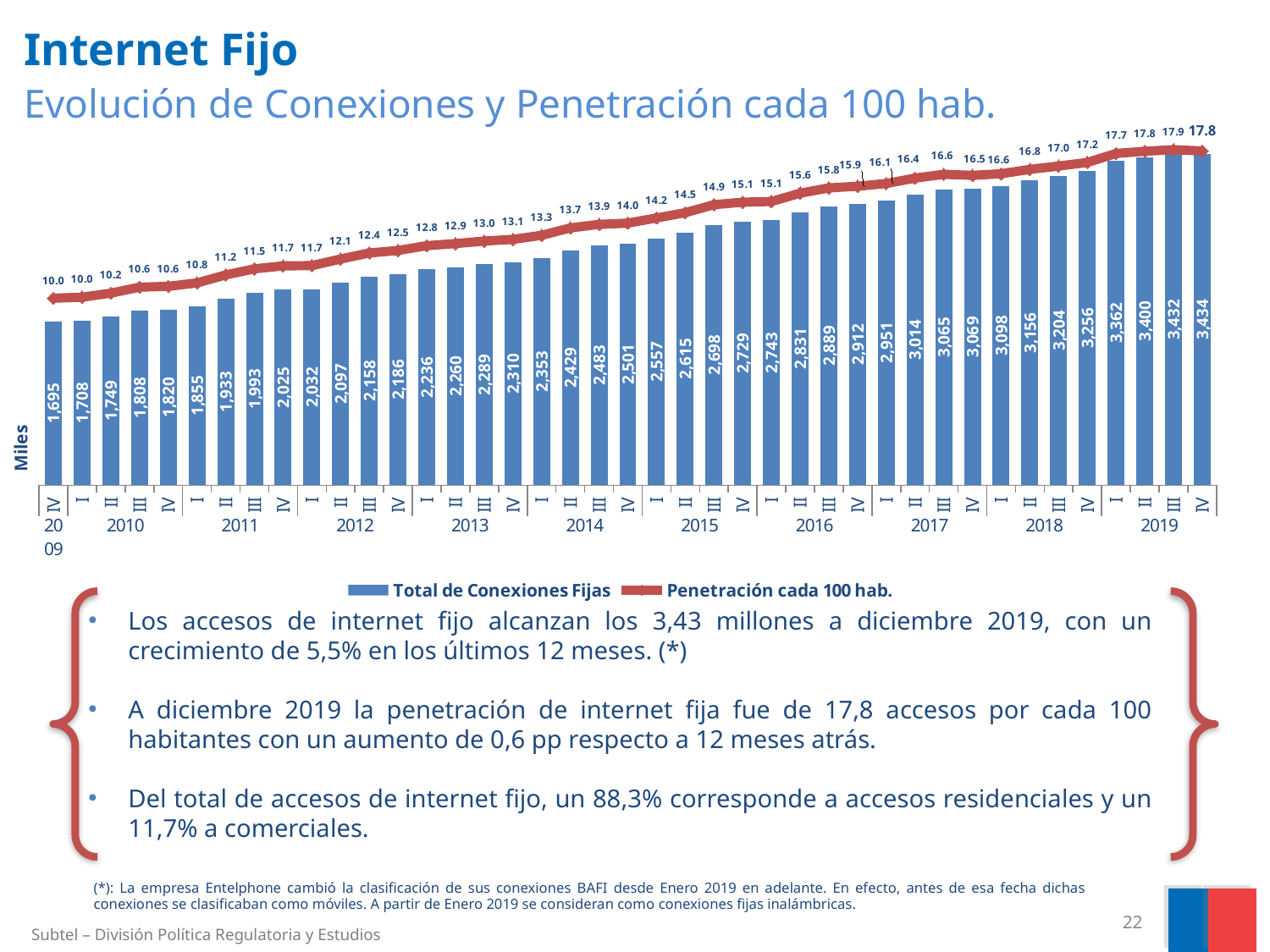
What is the Penetración cada 100 hab. value for IV 2018? 17.2 How many quarterly data points are plotted in the chart? 41 Which quarter has the lowest Total de Conexiones Fijas? IV 2009 What kind of chart is used to show Total de Conexiones Fijas? Bar chart Does the Penetración cada 100 hab. line generally rise or fall from IV 2009 to IV 2019? Rise What is the value of Total de Conexiones Fijas for IV 2019? 3,434 What is the difference in Total de Conexiones Fijas between IV 2019 and IV 2018? 178 What is the difference in Penetración cada 100 hab. between IV 2019 and IV 2009? 7.8 What is the value of Total de Conexiones Fijas for II 2014? 2,429 Which is larger, the Total de Conexiones Fijas for IV 2017 or for I 2018? I 2018 How many series does the legend list? 2 Which quarter has the highest Total de Conexiones Fijas? IV 2019